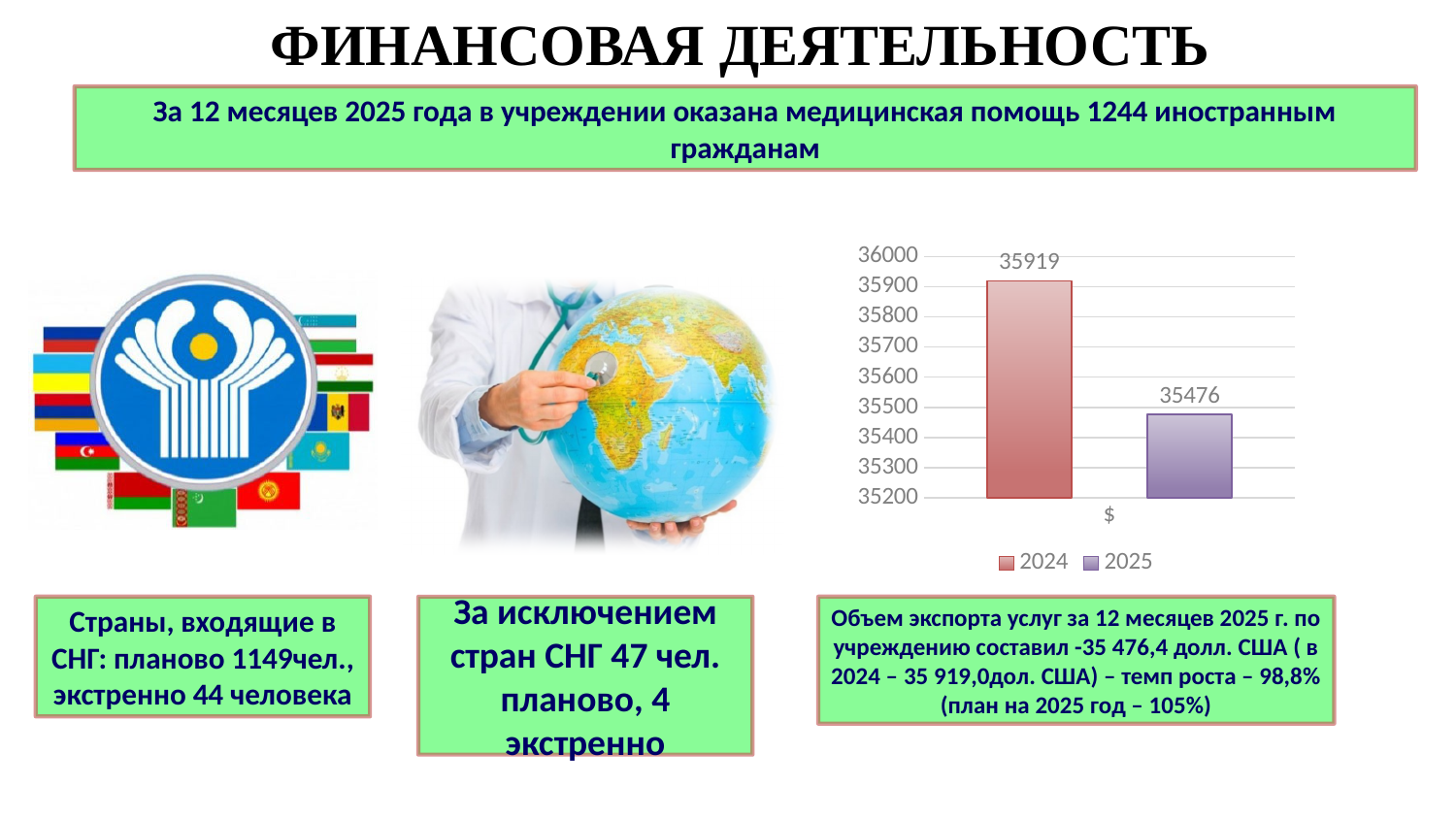
What is the value for 2024 in the chart? 35919 Do the values fall or rise from 2024 to 2025 in the chart? fall What colour is the bar for 2025 in the chart? purple What kind of chart is shown on the slide? bar chart What is the value for 2025 in the chart? 35476 Is the value for 2025 greater or less than 35500? less Is the value for 2024 greater or less than 35800? greater Which series has the lowest value in the chart? 2025 How many series does the chart legend list? 2 Which series has the higher value in the chart, 2024 or 2025? 2024 What is the difference between the 2024 and 2025 values in the chart? 443 What is the category label shown on the x axis of the chart? $